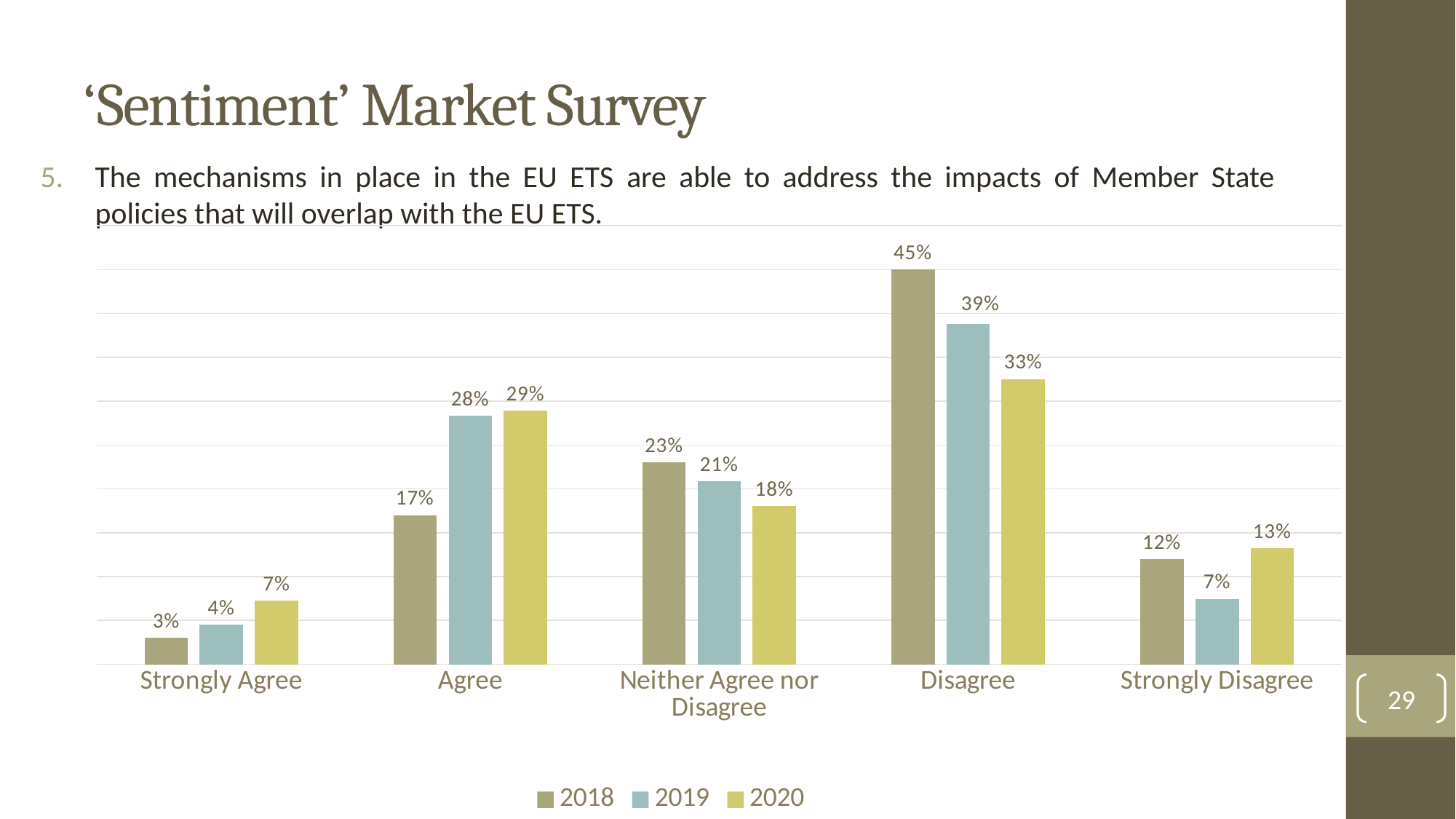
What is the value for Neither Agree nor Disagree in 2020? 18% How many series does the legend list? 3 Which category has the lowest value in the 2018 series? Strongly Agree What is the difference between the 2018 and 2020 values for Disagree? 12% What is the value for Agree in 2020? 29% What is the value for Disagree in 2018? 45% Does the value for Disagree rise or fall from 2018 to 2020? Fall Which category has the highest value in the 2019 series? Disagree Which is larger, the 2018 value for Strongly Disagree or the 2019 value for Strongly Disagree? 2018 What kind of chart is shown on the slide? Bar chart How many categories are shown on the x axis? 5 What is the value for Strongly Agree in 2019? 4%